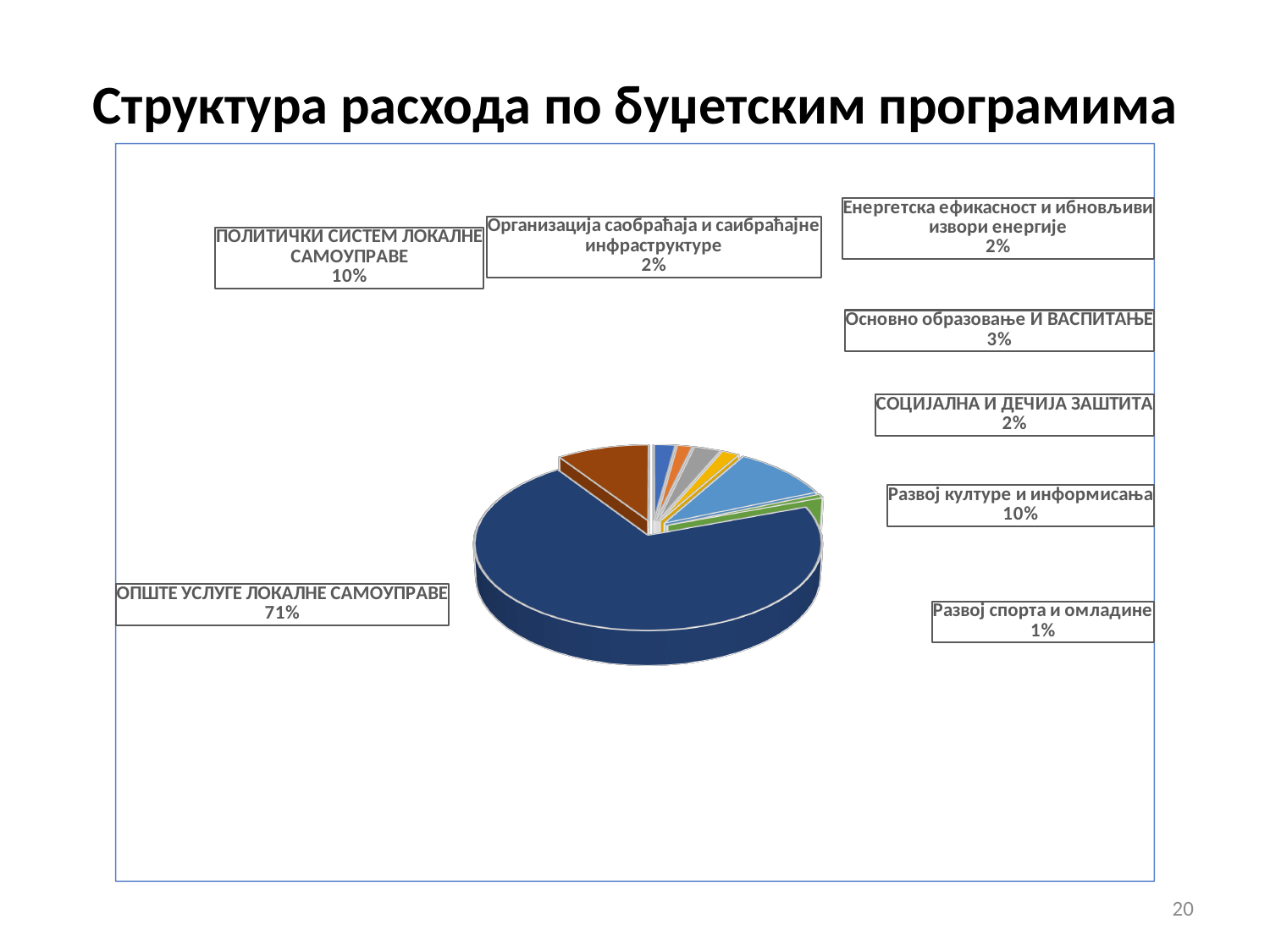
What is the value shown for Развој културе и информисања? 10% Which category has the largest share of the pie? ОПШТЕ УСЛУГЕ ЛОКАЛНЕ САМОУПРАВЕ What is the title of the slide? Структура расхода по буџетским програмима What share of the pie does ОПШТЕ УСЛУГЕ ЛОКАЛНЕ САМОУПРАВЕ have? 71% What type of chart is shown on the slide? pie chart Which category has the smallest share of the pie? Развој спорта и омладине What is the value shown for ПОЛИТИЧКИ СИСТЕМ ЛОКАЛНЕ САМОУПРАВЕ? 10% What is the value shown for Основно образовање И ВАСПИТАЊЕ? 3% What is the value shown for Развој спорта и омладине? 1% What is the value shown for СОЦИЈАЛНА И ДЕЧИЈА ЗАШТИТА? 2% What is the difference between the shares of ОПШТЕ УСЛУГЕ ЛОКАЛНЕ САМОУПРАВЕ and ПОЛИТИЧКИ СИСТЕМ ЛОКАЛНЕ САМОУПРАВЕ? 61% How many categories are labelled on the pie chart? 8